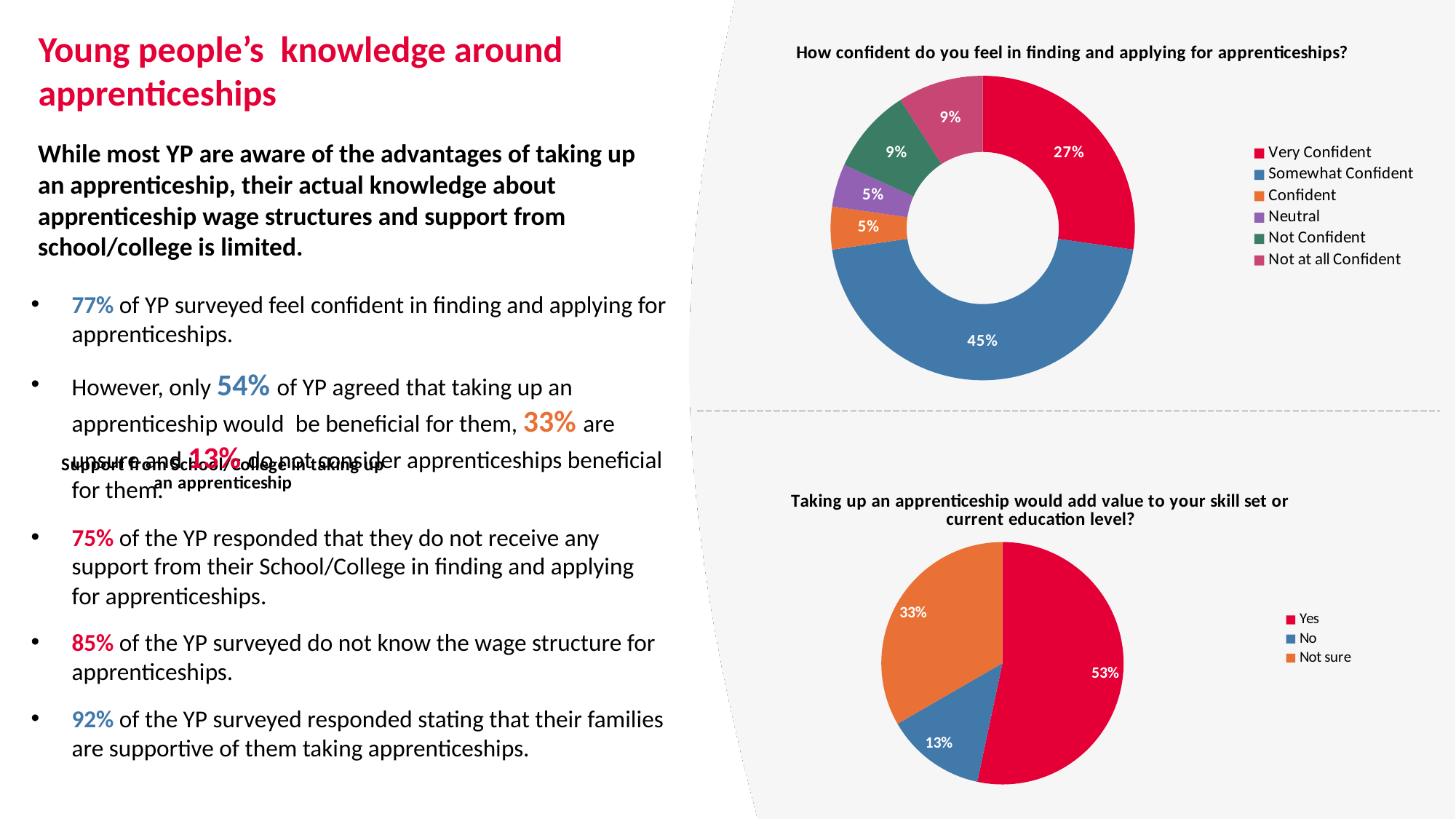
In the chart titled "Taking up an apprenticeship would add value to your skill set or current education level?", what percentage answered Yes? 53% In the chart titled "How confident do you feel in finding and applying for apprenticeships?", what is the difference between the Somewhat Confident and Very Confident shares? 18 percentage points In the chart titled "Taking up an apprenticeship would add value to your skill set or current education level?", what percentage answered Not sure? 33% In the chart titled "How confident do you feel in finding and applying for apprenticeships?", how many categories does the legend list? 6 In the chart titled "How confident do you feel in finding and applying for apprenticeships?", what percentage of respondents are Somewhat Confident? 45% In the chart titled "How confident do you feel in finding and applying for apprenticeships?", what percentage of respondents are Very Confident? 27% In the chart titled "Taking up an apprenticeship would add value to your skill set or current education level?", what colour represents the Not sure slice? Orange What kind of chart is the one titled "How confident do you feel in finding and applying for apprenticeships?"? Doughnut chart In the chart titled "Taking up an apprenticeship would add value to your skill set or current education level?", what is the difference between the Yes and No shares? 40 percentage points In the chart titled "Taking up an apprenticeship would add value to your skill set or current education level?", which response has the smallest share? No In the chart titled "How confident do you feel in finding and applying for apprenticeships?", which category has the largest share? Somewhat Confident In the chart titled "How confident do you feel in finding and applying for apprenticeships?", which is larger: Very Confident or Not Confident? Very Confident